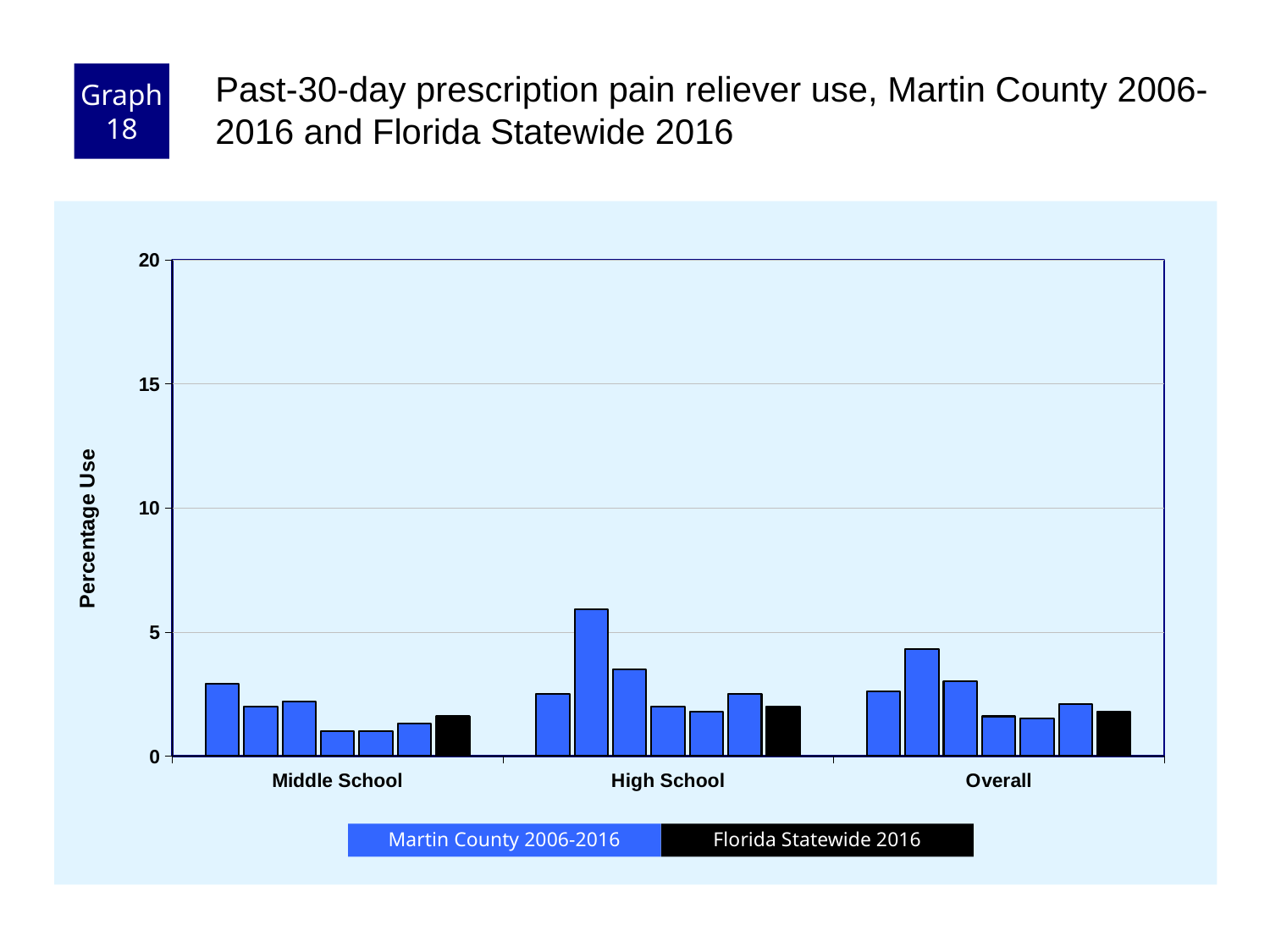
Is the Florida Statewide 2016 value for High School greater or less than 5? less Is the tallest Martin County bar in the High School group greater or less than 5? greater Are any bars on the chart greater than 10? No Is the Florida Statewide 2016 bar larger for High School or for Middle School? High School What is the label on the y axis? Percentage Use Which category group contains the tallest bar on the chart? High School What kind of chart is shown on the slide? bar chart How many category groups are shown along the x axis? 3 How many series does the legend list? 2 What colour represents Florida Statewide 2016 in the legend? black